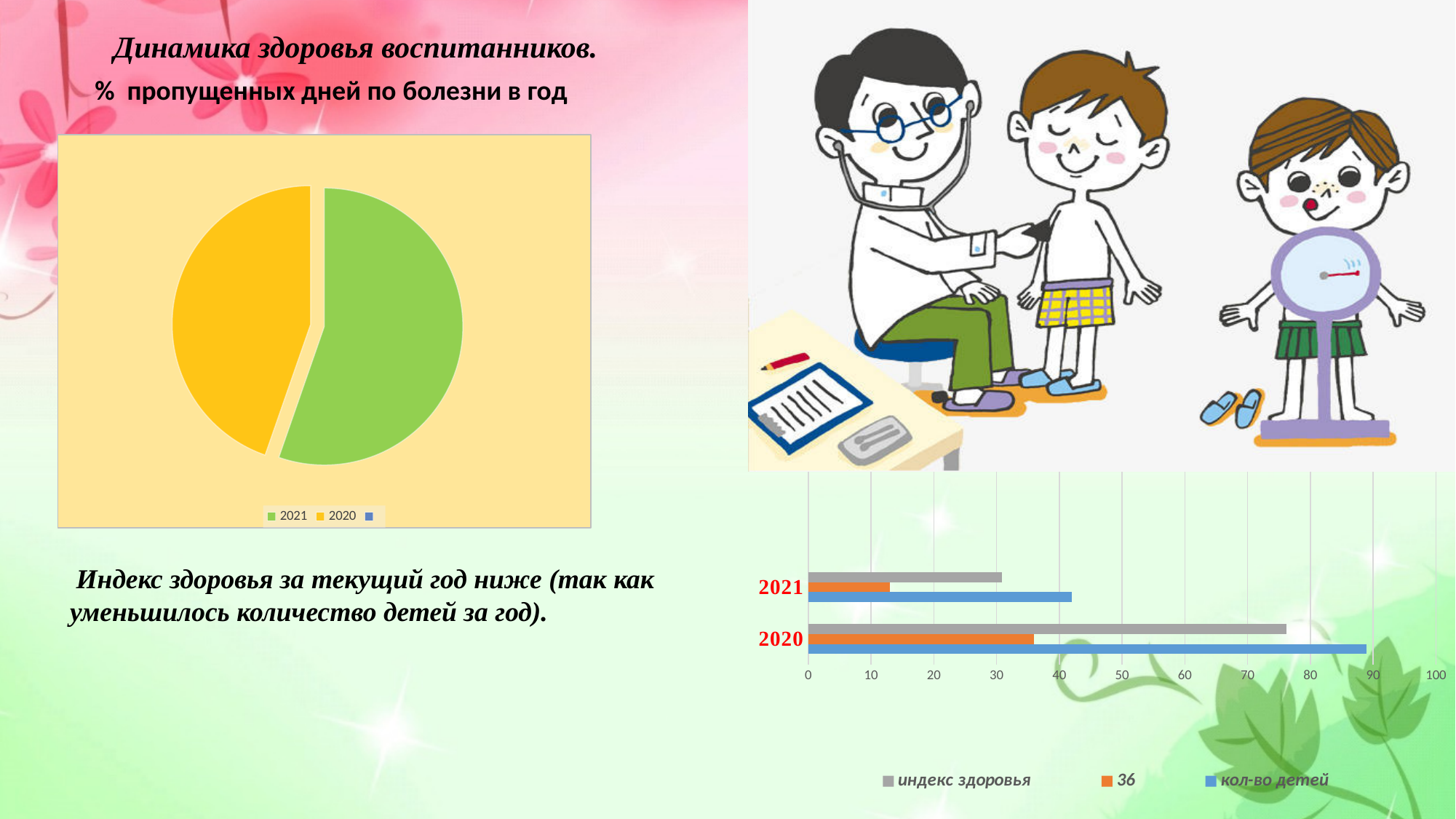
What kind of chart is the chart on the left of the slide? pie chart In the bar chart at the bottom right, which year has the lower value for индекс здоровья? 2021 In the pie chart on the left, what colour is the 2020 slice? yellow In the pie chart on the left, which slice is larger, 2021 or 2020? 2021 In the bar chart at the bottom right, is the value of кол-во детей for 2020 greater or less than 80? greater In the bar chart at the bottom right, is the value of индекс здоровья for 2021 greater or less than 40? less How many categories (years) are shown in the bar chart at the bottom right? 2 In the bar chart at the bottom right, is the value of индекс здоровья for 2020 greater or less than 70? greater In the bar chart at the bottom right, which year has the higher value for кол-во детей? 2020 How many series does the legend of the bar chart at the bottom right list? 3 What kind of chart is the chart at the bottom right of the slide? bar chart